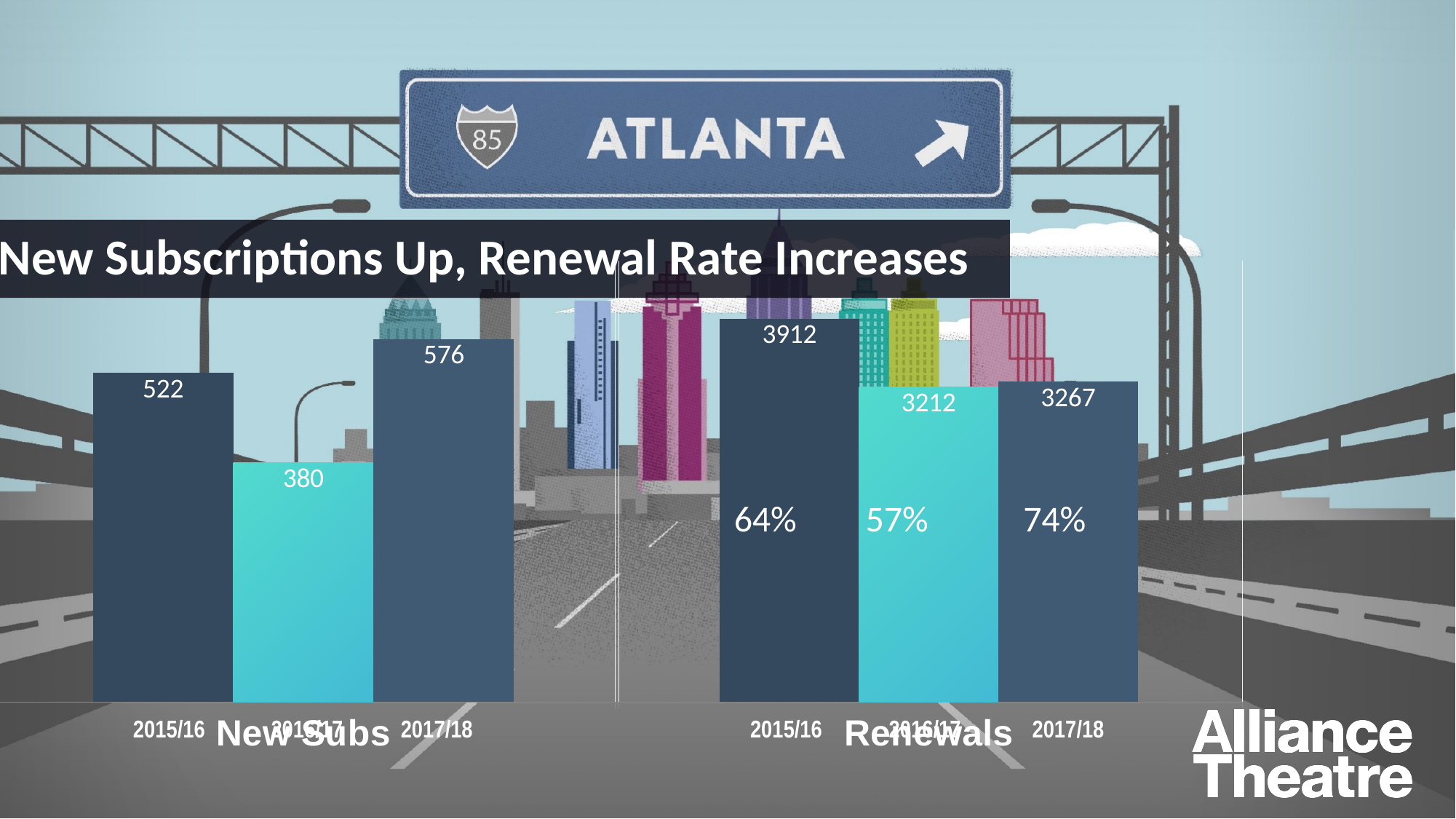
How many bars does the New Subs chart have? 3 In the Renewals chart, which is larger: the 2017/18 value or the 2015/16 value? 2015/16 In the New Subs chart, what is the value for 2015/16? 522 In the Renewals chart, which year has the highest number of renewals? 2015/16 In the Renewals chart, what renewal rate percentage is shown for 2017/18? 74% In the Renewals chart, what is the value for 2015/16? 3912 In the Renewals chart, what renewal rate percentage is shown for 2015/16? 64% In the New Subs chart, what is the value for 2017/18? 576 What type of chart is the Renewals chart? Bar chart In the New Subs chart, what is the difference between the 2017/18 value and the 2015/16 value? 54 In the New Subs chart, which year has the highest value? 2017/18 In the New Subs chart, what is the value of the middle (teal) bar? 380